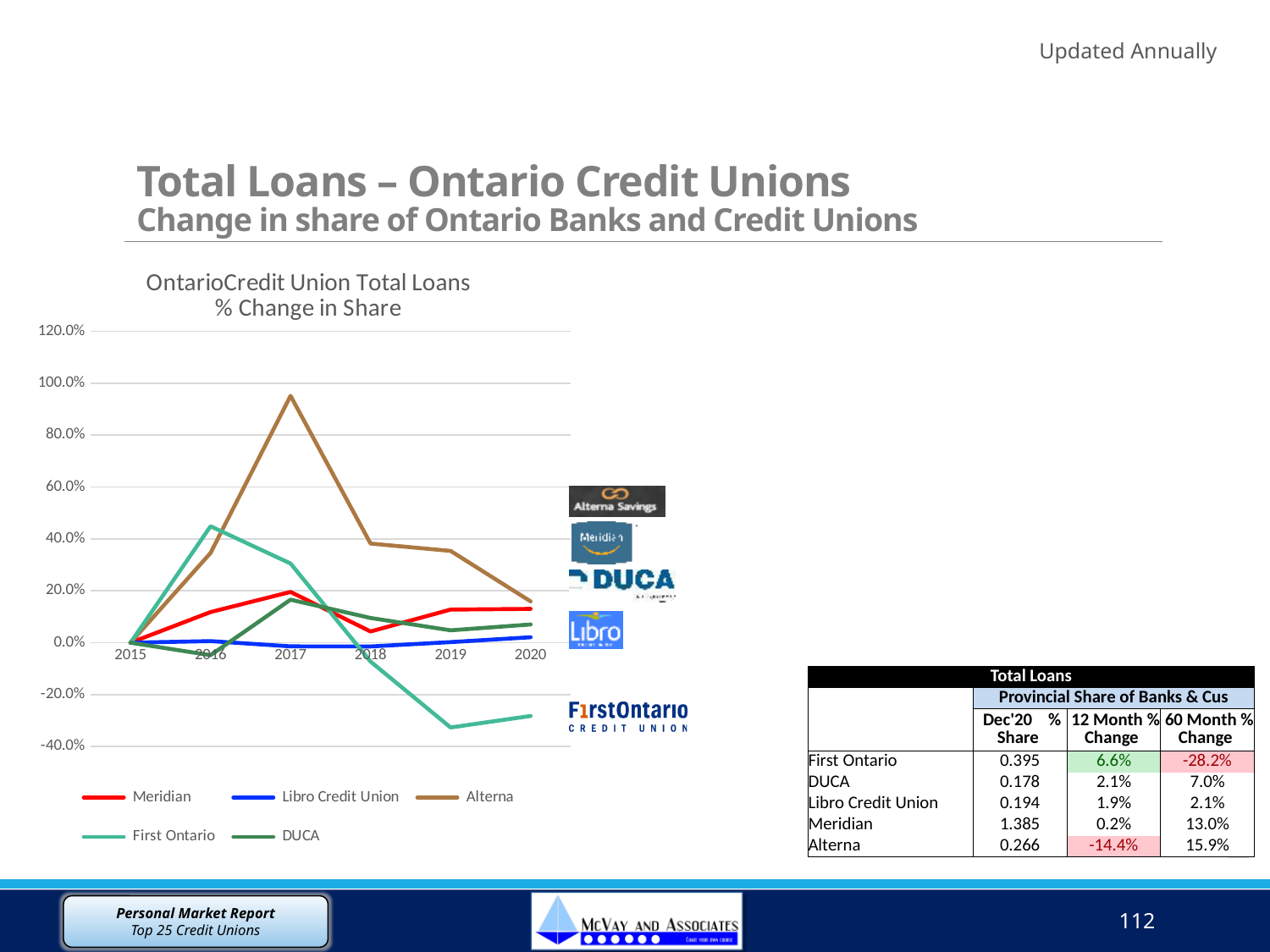
What is the title of the chart? OntarioCredit Union Total Loans % Change in Share In 2020, which is larger: the value for Meridian or the value for Libro Credit Union? Meridian What kind of chart is shown on the slide? line chart How many series does the chart's legend list? 5 Is the value for Alterna in 2018 greater or less than 20.0%? greater Which series has the highest value in 2017? Alterna Is the value for Alterna in 2017 greater or less than 80.0%? greater Does the Alterna line rise or fall from 2017 to 2020? fall How many years are shown along the x axis of the chart? 6 Which series has the highest value in 2016? First Ontario Which series has the lowest value in 2019? First Ontario Is the value for First Ontario in 2019 greater or less than -20.0%? less